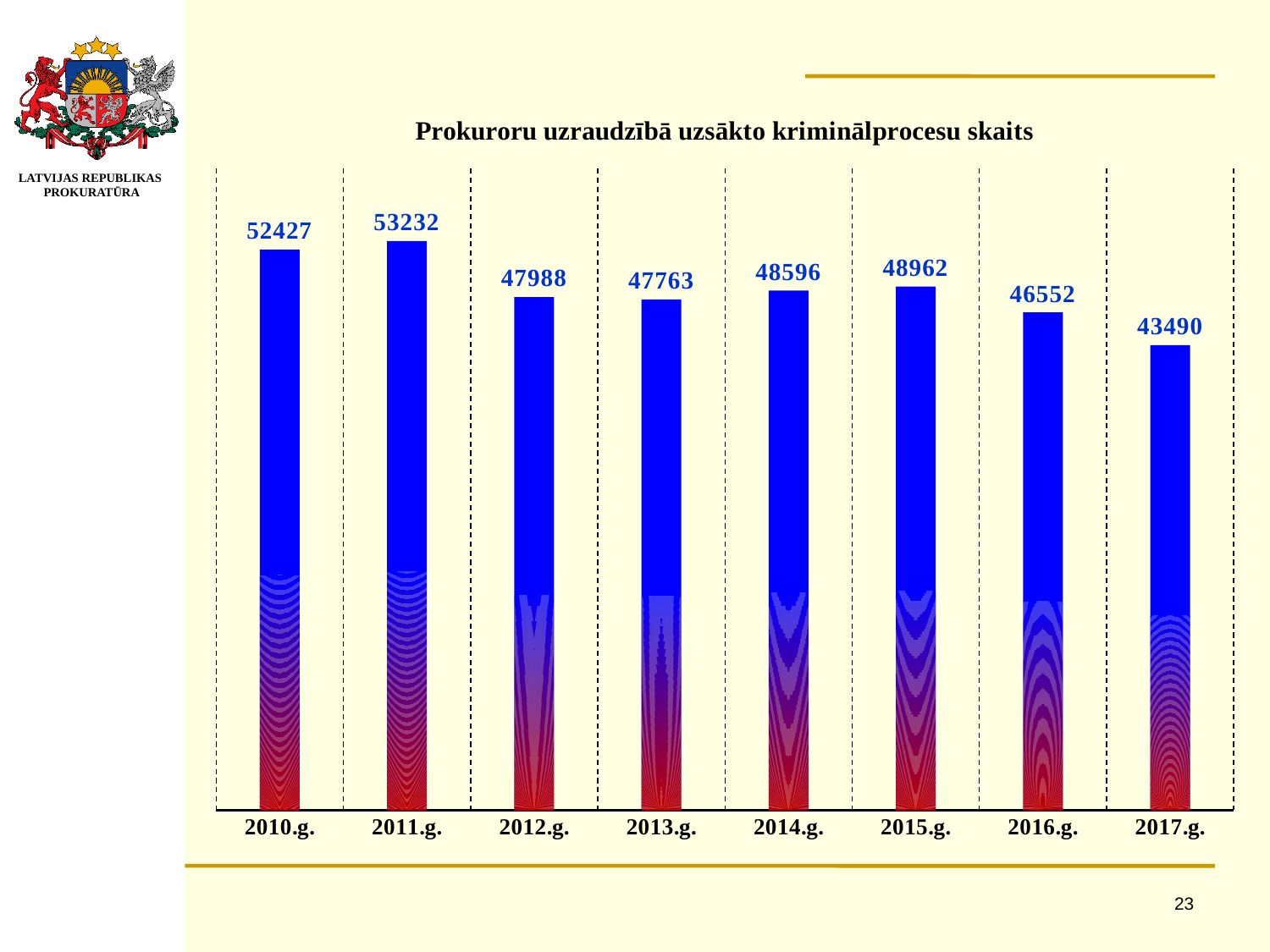
What is the difference between the values for 2011.g. and 2010.g.? 805 Which year has the lowest value? 2017.g. How many years are shown on the x axis? 8 What is the value for 2010.g.? 52427 What is the difference between the values for 2016.g. and 2017.g.? 3062 Which is larger, the value for 2012.g. or the value for 2013.g.? 2012.g. What is the title of the chart? Prokuroru uzraudzībā uzsākto kriminālprocesu skaits Which year has the highest value? 2011.g. What is the value for 2014.g.? 48596 Which is larger, the value for 2015.g. or the value for 2014.g.? 2015.g. What is the value for 2017.g.? 43490 What kind of chart is this? bar chart